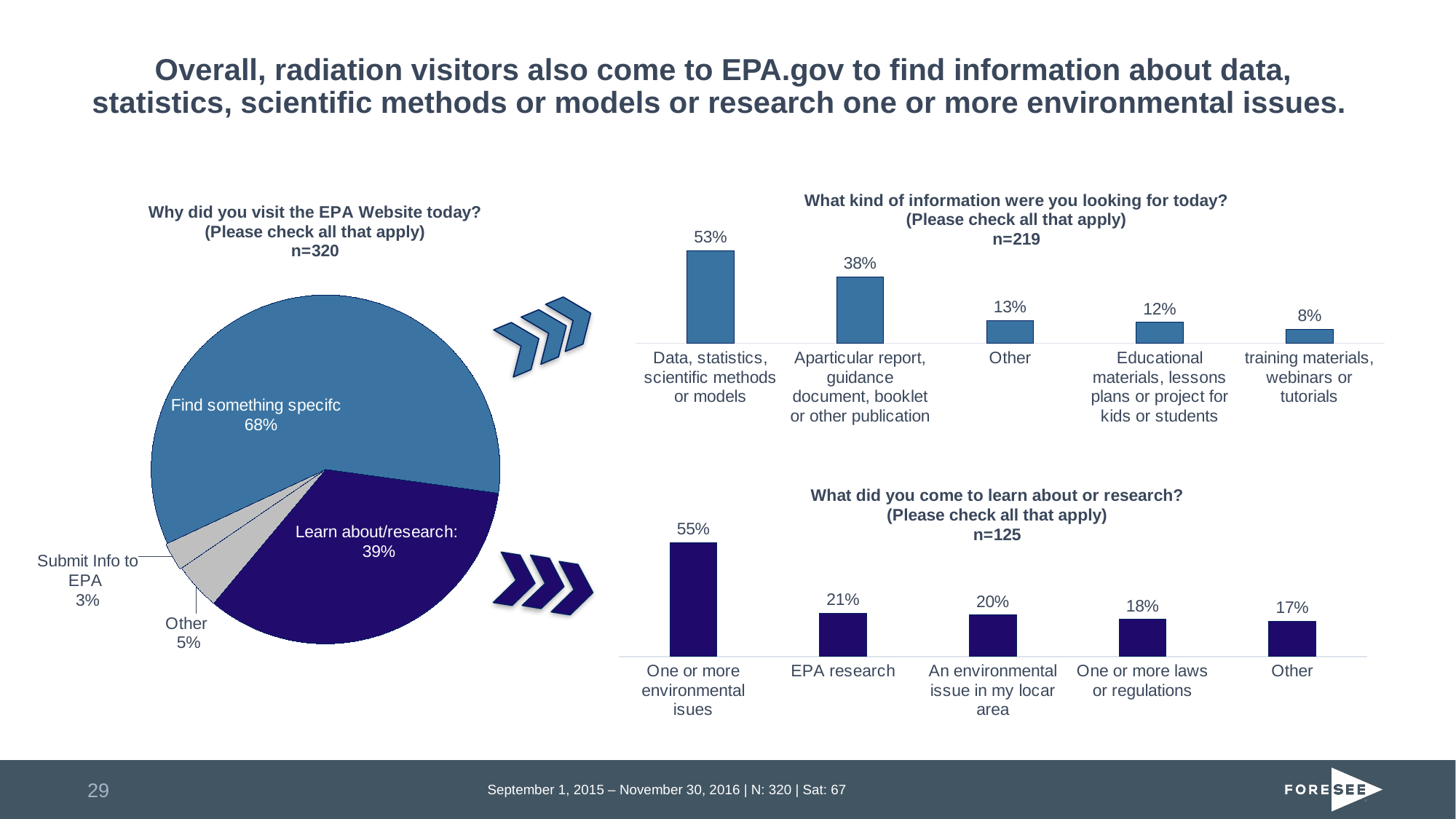
How many categories are shown in the chart 'What did you come to learn about or research?'? 5 In the chart 'What kind of information were you looking for today?', which category has the lowest value? training materials, webinars or tutorials In the pie chart 'Why did you visit the EPA Website today?', what share is labelled for 'Submit Info to EPA'? 3% In the pie chart 'Why did you visit the EPA Website today?', what share is labelled for 'Find something specifc'? 68% In the chart 'What kind of information were you looking for today?', what is the value for 'Data, statistics, scientific methods or models'? 53% What kind of chart is 'What did you come to learn about or research?'? Bar chart In the chart 'What kind of information were you looking for today?', what is the difference between 'Data, statistics, scientific methods or models' and 'Aparticular report, guidance document, booklet or other publication'? 15% In the chart 'What did you come to learn about or research?', which category has the highest value? One or more environmental isues How many slices does the pie chart 'Why did you visit the EPA Website today?' have? 4 In the pie chart 'Why did you visit the EPA Website today?', which slice is the smallest? Submit Info to EPA In the chart 'What did you come to learn about or research?', which is larger: 'One or more laws or regulations' or 'Other'? One or more laws or regulations In the chart 'What did you come to learn about or research?', what is the value for 'EPA research'? 21%